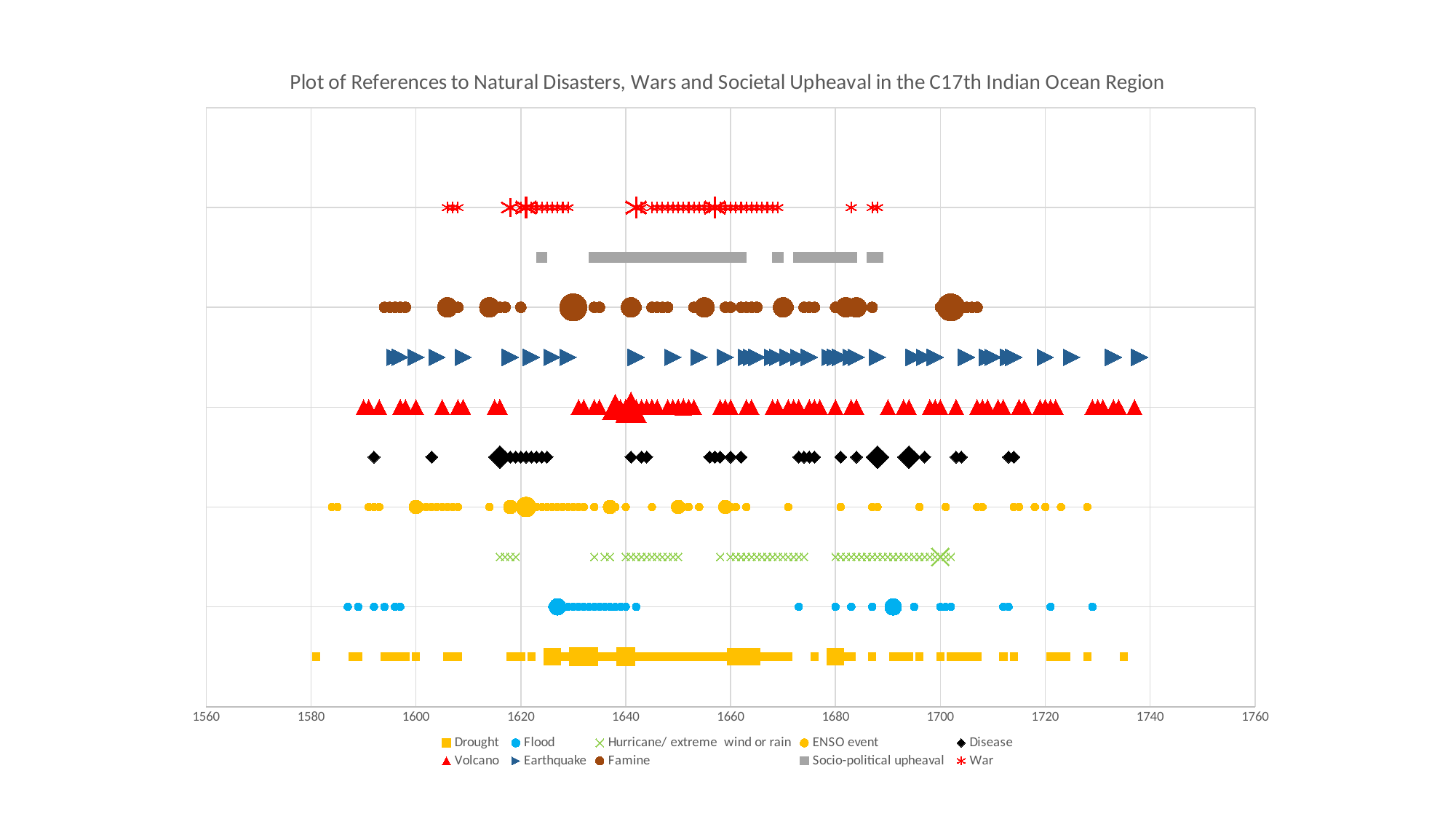
Which series has the earliest marker on the chart? Drought What is the lowest year shown on the x axis? 1560 Is the earliest War marker before or after 1600? after What kind of chart is shown on the slide? scatter chart How many series does the legend list? 10 Is the latest Famine marker before or after 1700? after Is the earliest Flood marker before or after 1580? after What is the title of the chart? Plot of References to Natural Disasters, Wars and Societal Upheaval in the C17th Indian Ocean Region